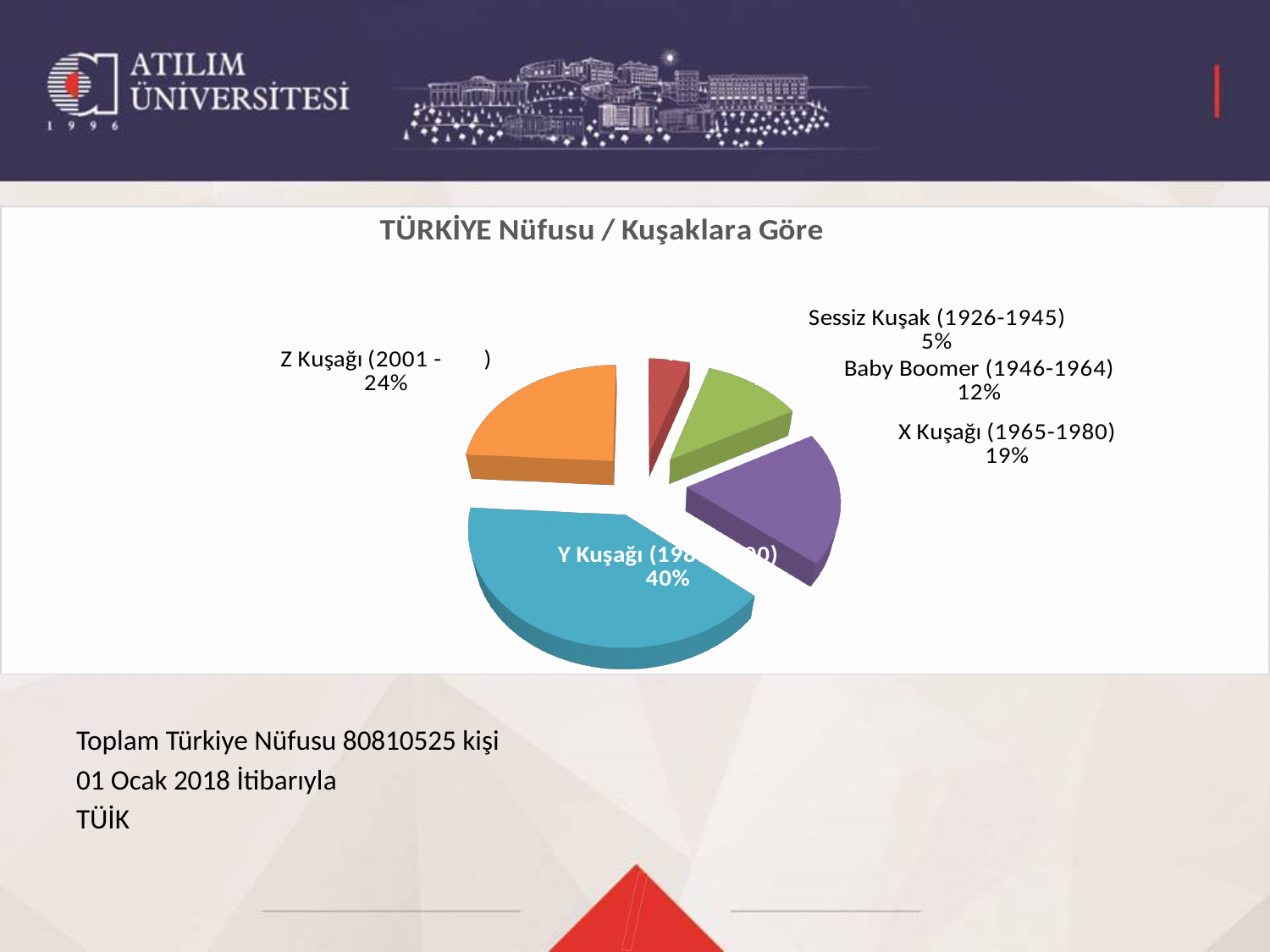
What share of the pie does Y Kuşağı have? 40% How many slices does the pie chart have? 5 What type of chart is shown on the slide? Pie chart What is the title of the chart? TÜRKİYE Nüfusu / Kuşaklara Göre What share of the pie does Sessiz Kuşak (1926-1945) have? 5% What is the difference in percentage points between Z Kuşağı (2001 - ) and X Kuşağı (1965-1980)? 5 Which generation has the largest share of the pie? Y Kuşağı What share of the pie does Baby Boomer (1946-1964) have? 12% Which generation has the smallest share of the pie? Sessiz Kuşak (1926-1945) Which has a larger share, Baby Boomer (1946-1964) or X Kuşağı (1965-1980)? X Kuşağı (1965-1980)